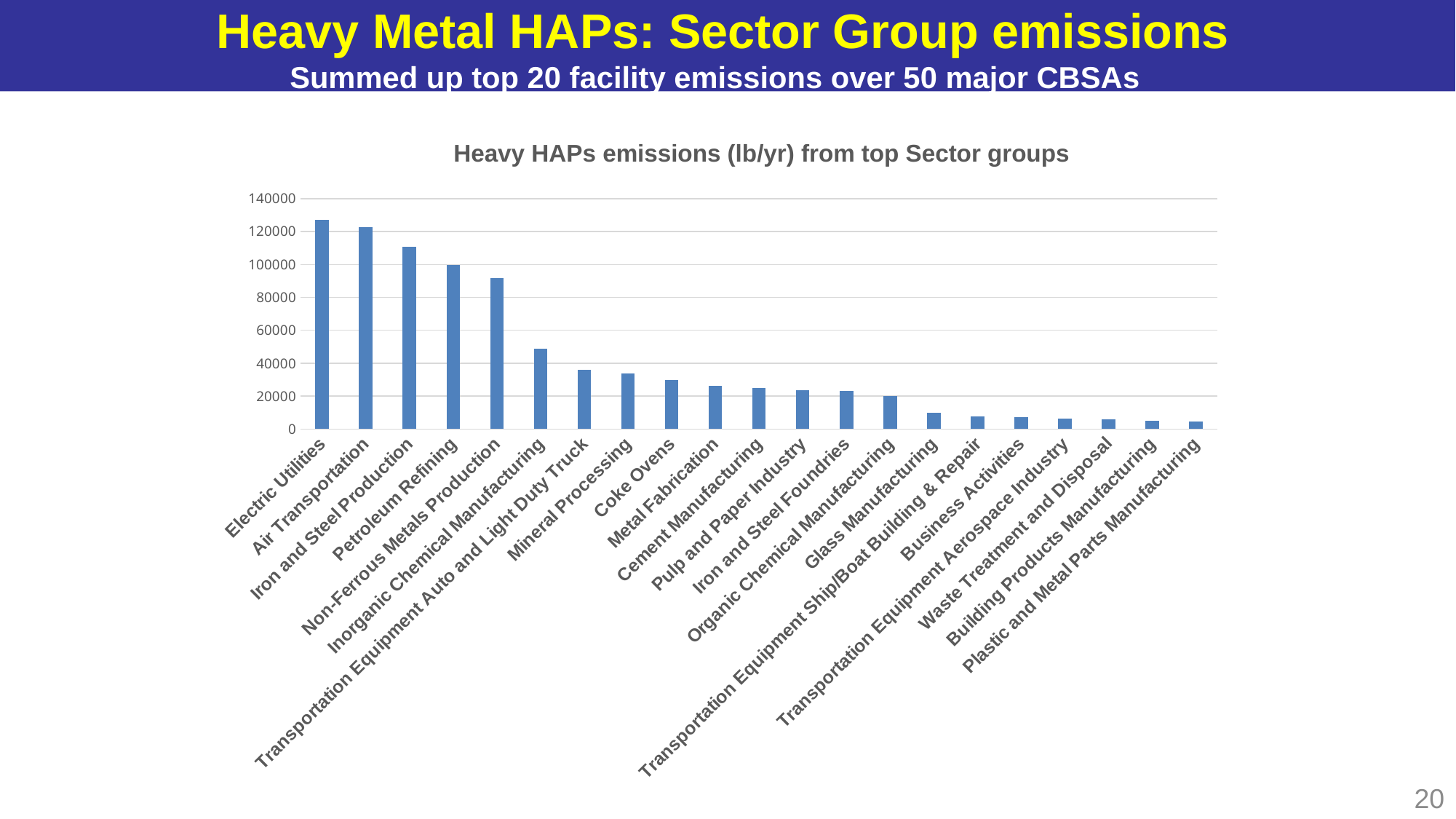
Is the value for Electric Utilities greater or less than 120000? greater What kind of chart is shown on the slide? bar chart Is the value for Inorganic Chemical Manufacturing greater or less than 60000? less Is the value for Coke Ovens greater or less than 20000? greater What is the title of the chart? Heavy HAPs emissions (lb/yr) from top Sector groups Do the emission values rise or fall moving from left to right along the x axis? fall Which has higher emissions, Inorganic Chemical Manufacturing or Mineral Processing? Inorganic Chemical Manufacturing Which sector group has the highest emissions? Electric Utilities How many sector groups are plotted in the chart? 21